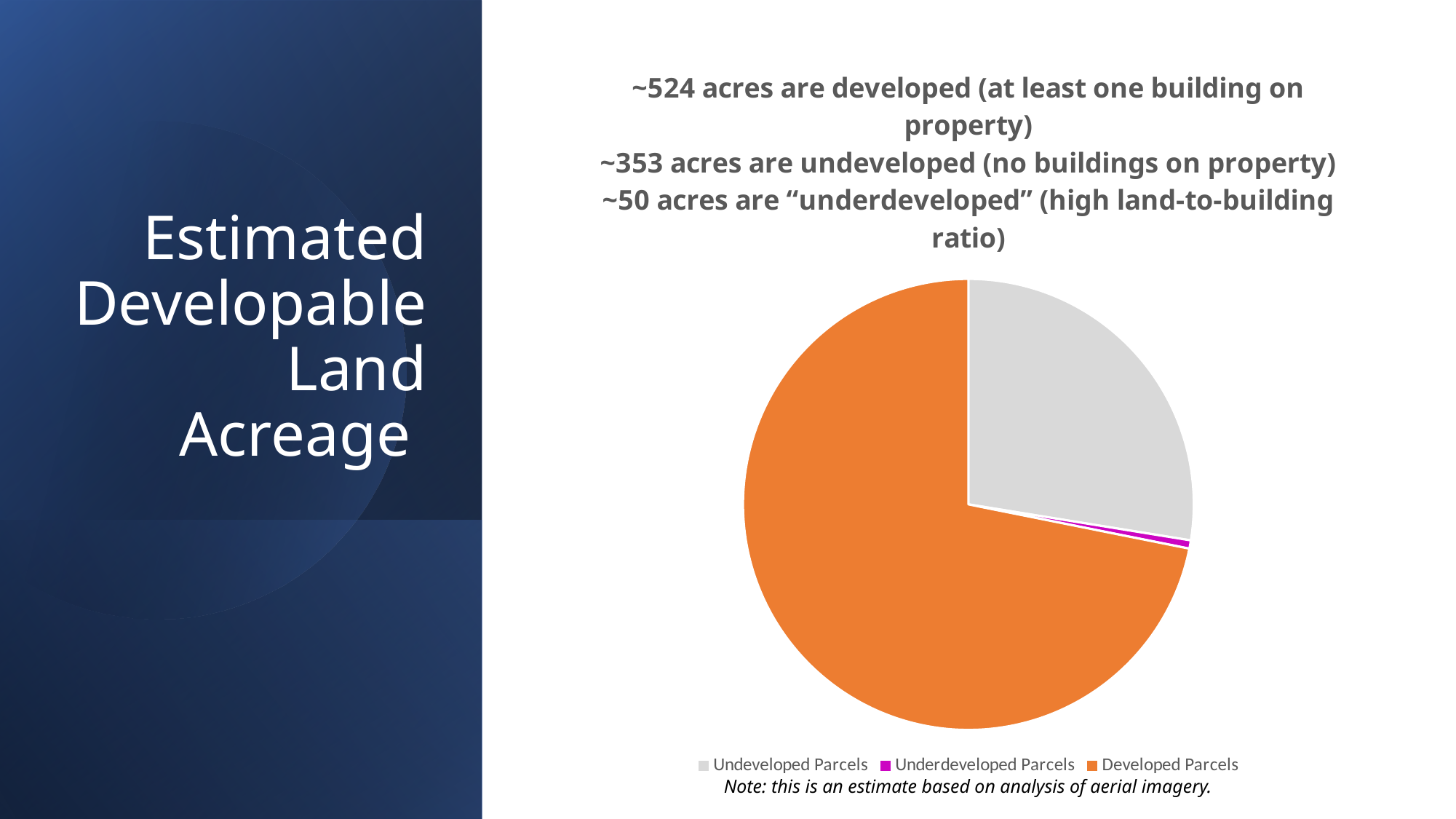
Does the Developed Parcels slice take up more or less than half of the pie? More Which slice is larger, Developed Parcels or Undeveloped Parcels? Developed Parcels What colour represents Undeveloped Parcels in the pie chart? Grey How many slices does the pie chart have? 3 What colour represents Developed Parcels in the pie chart? Orange Which category has the largest slice of the pie chart? Developed Parcels How many entries does the legend of the pie chart list? 3 What kind of chart is shown on the slide? Pie chart Which slice is larger, Undeveloped Parcels or Underdeveloped Parcels? Undeveloped Parcels Which category has the smallest slice of the pie chart? Underdeveloped Parcels